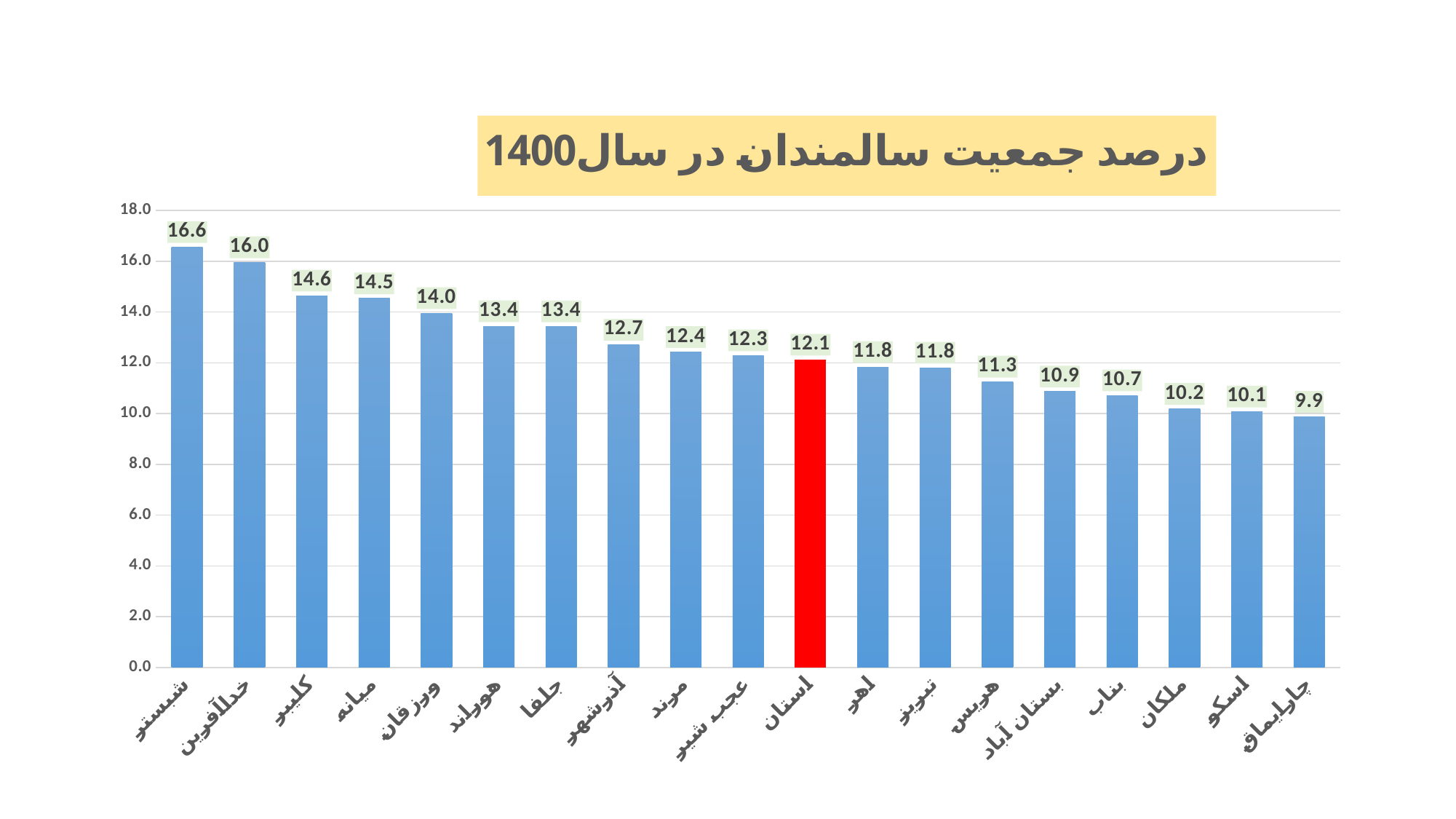
Which category has the highest value? شبستر How many bars are shown in the chart? 19 Which is larger, the value for خداآفرین or the value for میانه? خداآفرین What is the value for the red bar labelled استان? 12.1 What is the difference between the values for شبستر and چاراویماق? 6.7 What kind of chart is shown on the slide? bar chart Which category has the lowest value? چارایماق Which bar is coloured red instead of blue? استان What is the value for تبریز? 11.8 What is the difference between the values for کلیبر and مرند? 2.2 Is the value for بناب greater or less than 12.0? less What is the value for شبستر? 16.6